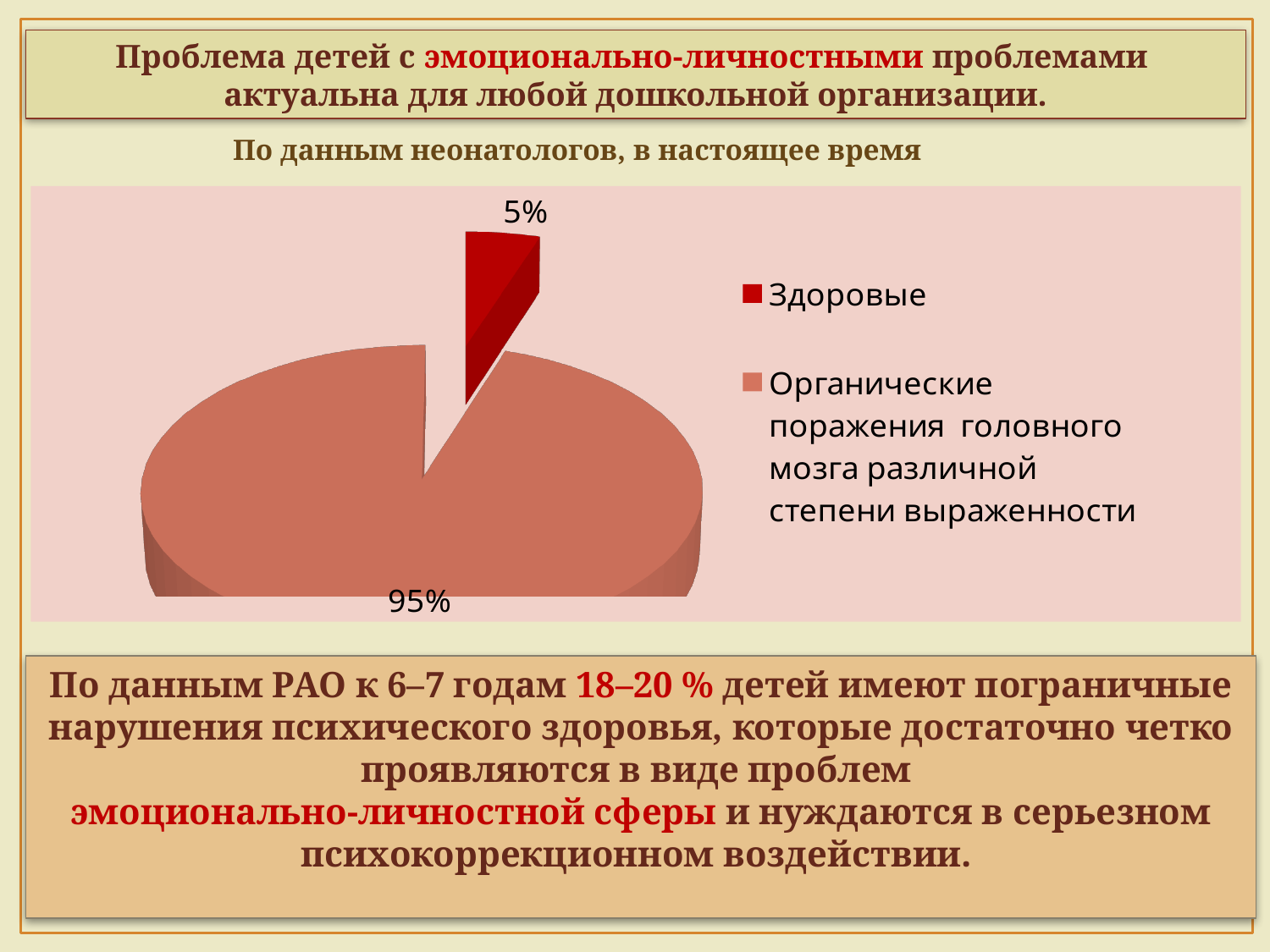
What kind of chart is shown on the slide? Pie chart What percentage is shown for the "Органические поражения головного мозга различной степени выраженности" slice? 95% How many entries does the legend list? 2 What is the heading shown above the pie chart? По данным неонатологов, в настоящее время What is the difference in percentage points between the two slices of the pie? 90 What percentage is shown for the "Здоровые" slice? 5% How many slices does the pie chart have? 2 Which slice of the pie is the smallest? Здоровые Which slice of the pie is the largest? Органические поражения головного мозга различной степени выраженности What colour is the "Здоровые" slice in the pie chart? Dark red Which is larger: the "Здоровые" slice or the "Органические поражения головного мозга" slice? Органические поражения головного мозга различной степени выраженности What share of the pie does the "Здоровые" slice represent? 5%